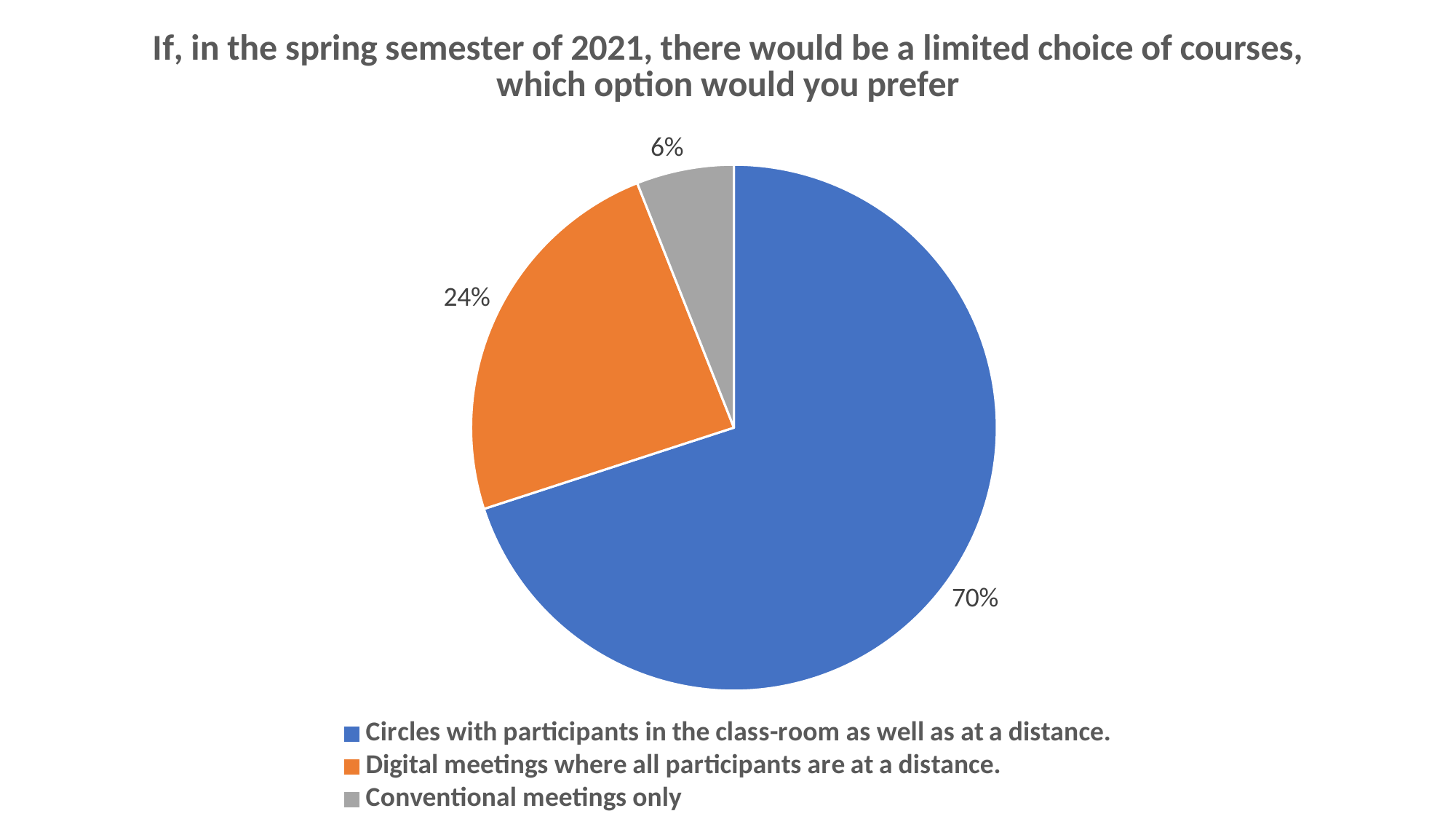
What kind of chart is shown on the slide? Pie chart What colour is the slice for 'Conventional meetings only'? Grey What share of the pie is 'Circles with participants in the class-room as well as at a distance.'? 70% How many slices does the pie chart have? 3 What share of the pie is 'Conventional meetings only'? 6% What is the title of the chart? If, in the spring semester of 2021, there would be a limited choice of courses, which option would you prefer What share of the pie is 'Digital meetings where all participants are at a distance.'? 24% What is the difference in percentage points between 'Circles with participants in the class-room as well as at a distance.' and 'Digital meetings where all participants are at a distance.'? 46 percentage points Which option has the smallest share of the pie? Conventional meetings only What is the difference in percentage points between 'Digital meetings where all participants are at a distance.' and 'Conventional meetings only'? 18 percentage points Which option has the largest share of the pie? Circles with participants in the class-room as well as at a distance. Which is larger: the share for 'Digital meetings where all participants are at a distance.' or the share for 'Conventional meetings only'? Digital meetings where all participants are at a distance.